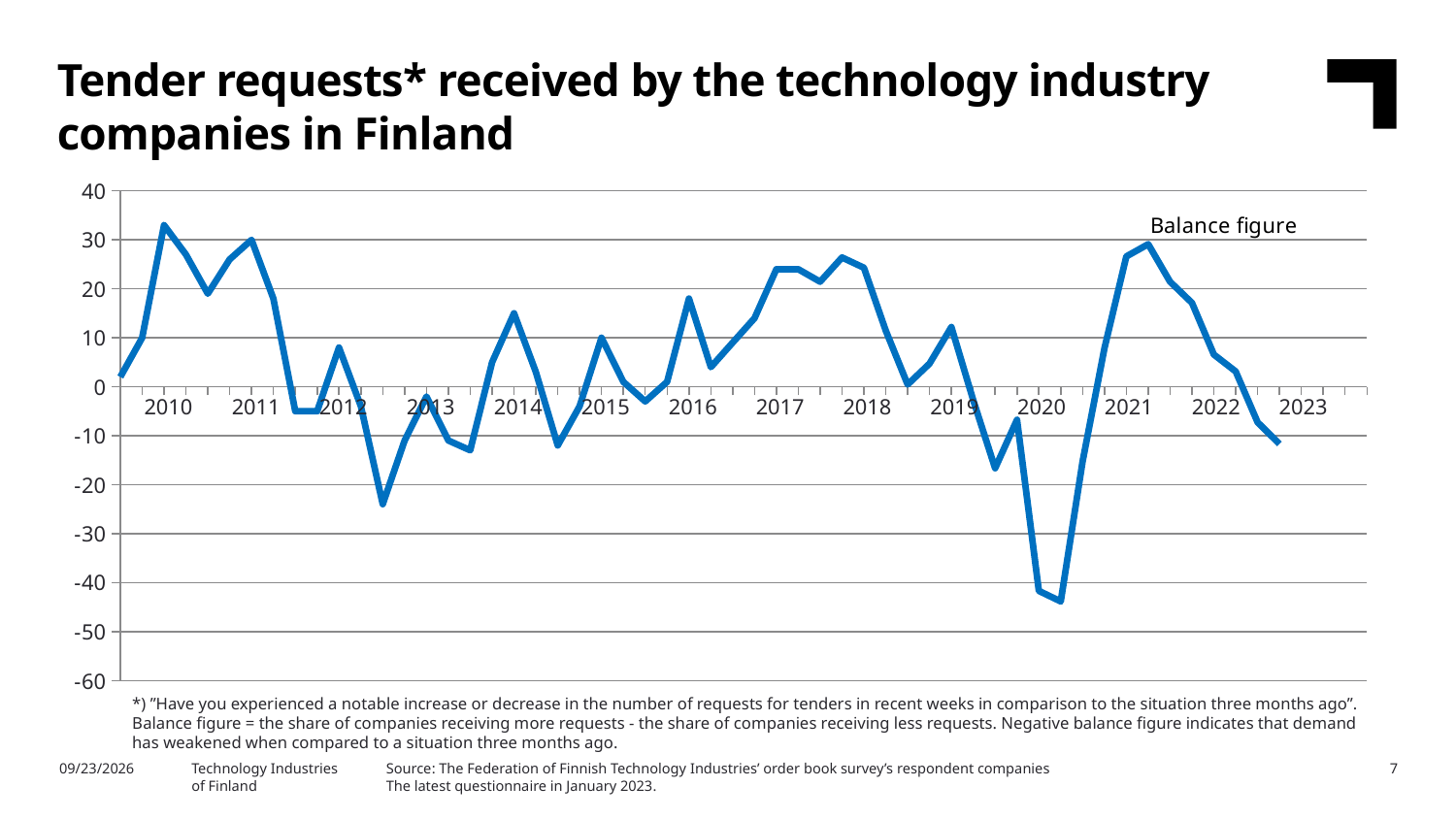
What is the title of the chart on the slide? Tender requests* received by the technology industry companies in Finland Which is higher: the lowest balance figure in 2012 or the lowest balance figure in 2020? 2012 What kind of chart is shown on the slide? Line chart Does the balance figure rise or fall from its 2021 peak to the end of the series in 2023? Fall What is the name of the series plotted in the chart? Balance figure Is the lowest value of the balance figure in 2020 greater or less than -30? less Is the lowest value of the balance figure in 2012 greater or less than -10? less Does the balance figure rise or fall from its low point in 2020 to its peak in 2021? Rise How many year labels are shown on the x axis of the chart? 14 Is the last plotted value of the balance figure in 2023 greater or less than 0? less In which year does the balance figure reach its lowest point? 2020